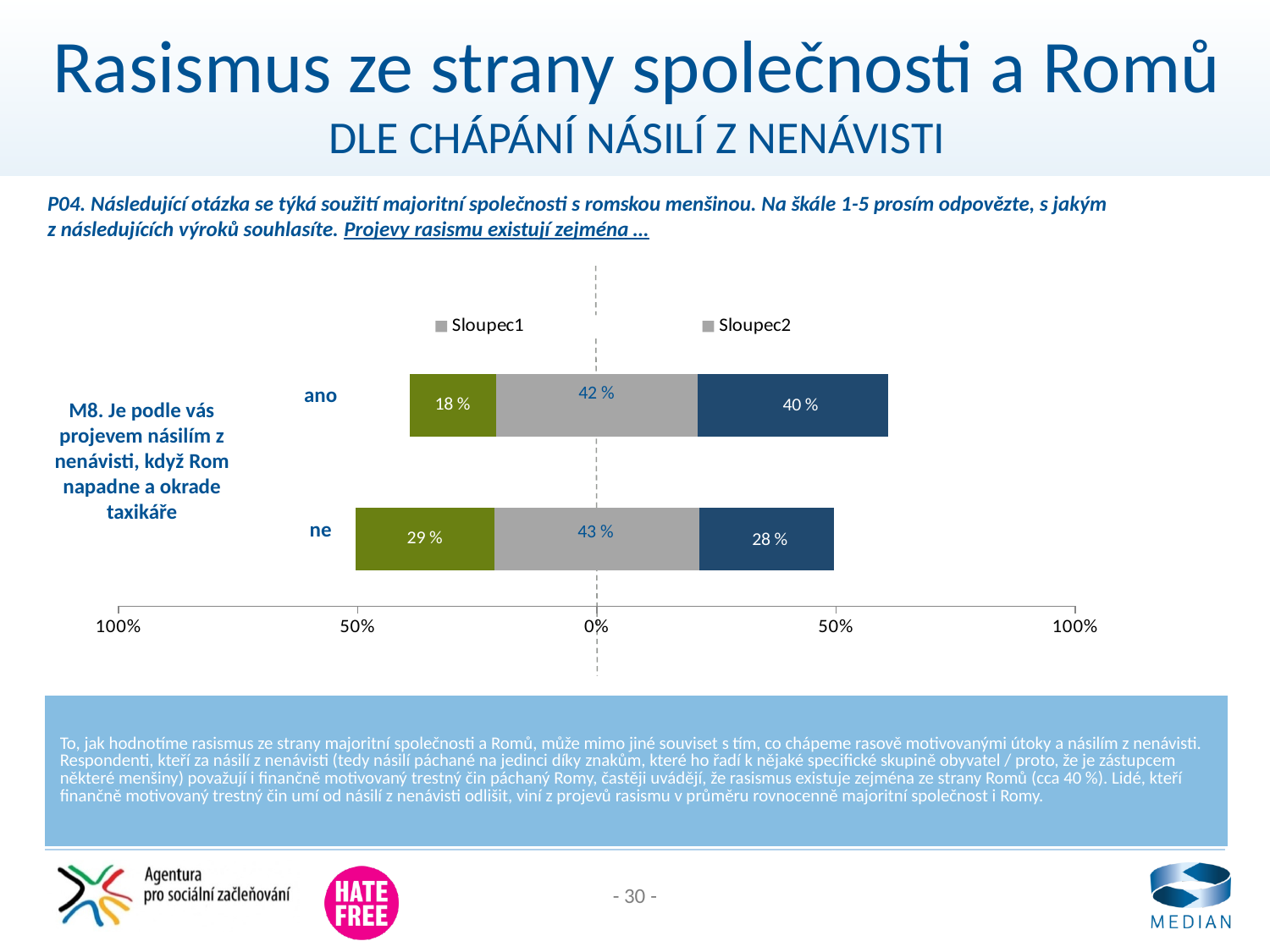
What is the value of the dark blue segment for the "ano" bar? 40 % What is the total of the three segments in the "ano" bar? 100 % Which bar has the larger green segment, "ano" or "ne"? ne What is the difference between the dark blue segment values of the "ano" bar and the "ne" bar? 12 % How many series does the legend list? 2 How many categories (bars) are shown in the chart? 2 What is the value of the green segment for the "ano" bar? 18 % Which bar has the larger dark blue segment, "ano" or "ne"? ano What is the value of the grey middle segment for the "ne" bar? 43 % What kind of chart is shown on the slide? Stacked bar chart What is the value of the dark blue segment for the "ne" bar? 28 % What is the difference between the green segment values of the "ne" bar and the "ano" bar? 11 %